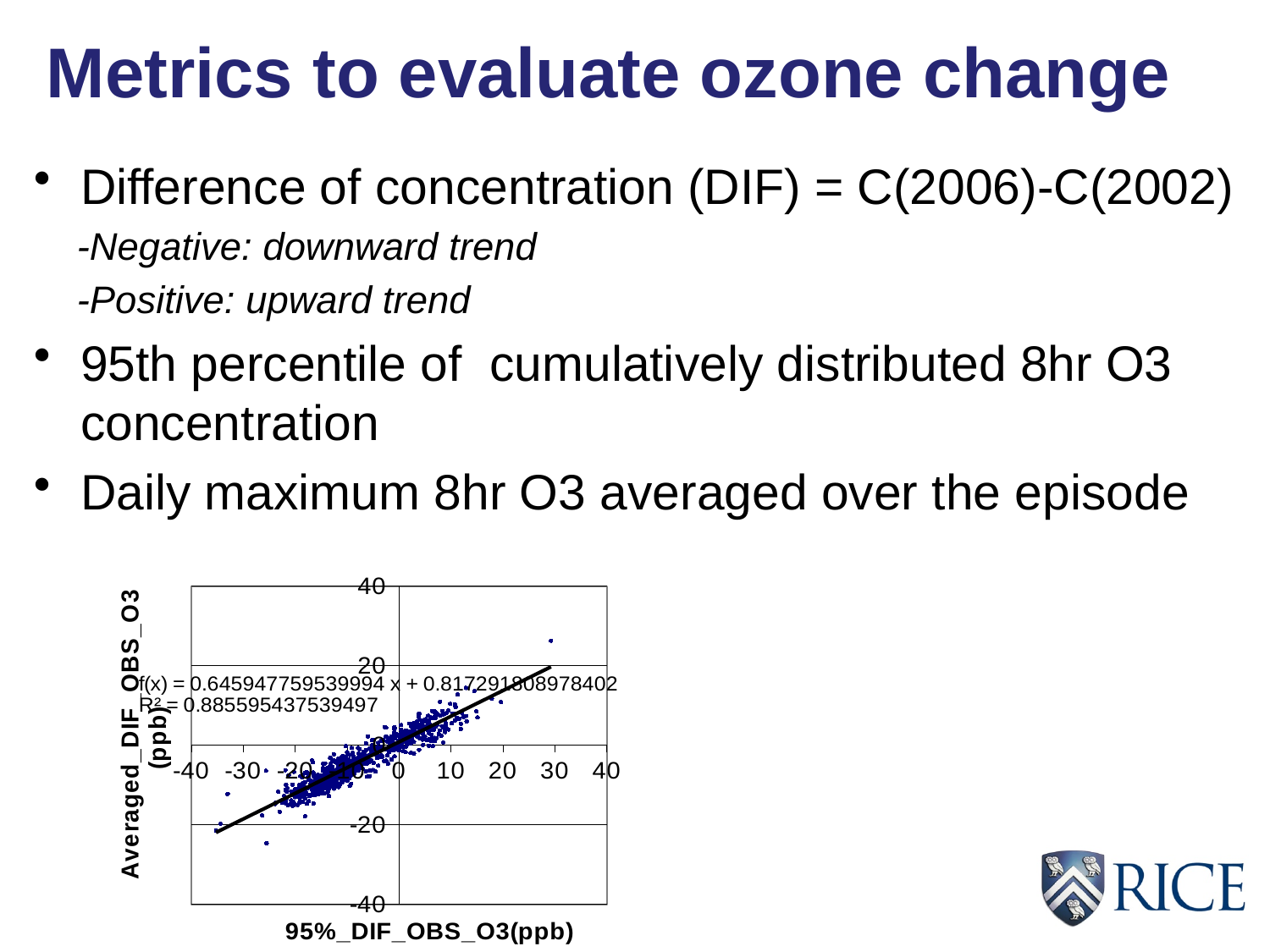
What is the maximum value shown on the y axis of the chart? 40 What is the minimum value shown on the x axis of the chart? -40 What is the label of the x axis of the chart? 95%_DIF_OBS_O3(ppb) What is the intercept of the fitted line f(x) shown on the chart? 0.817291808978402 Is the slope of the fitted line greater or less than 1? less Do the plotted points rise or fall as the x-axis value increases? Rise What kind of chart is shown on the slide? Scatter plot Is the R² value printed on the chart greater or less than 0.5? greater What is the slope of the fitted line f(x) shown on the chart? 0.645947759539994 What R² value is printed on the chart for the fitted line? 0.885595437539497 What is the label of the y axis of the chart? Averaged_DIF_OBS_O3 (ppb)